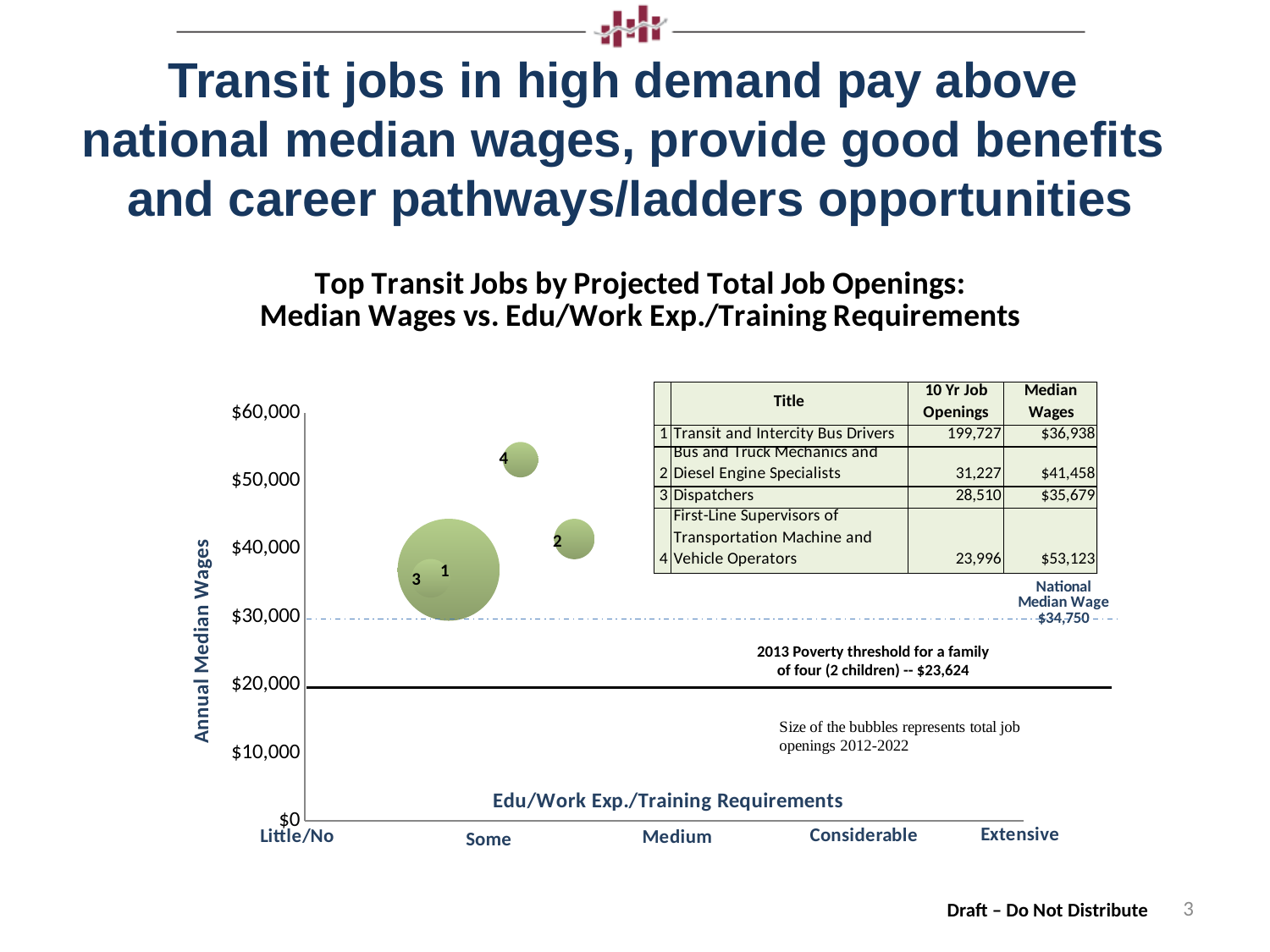
How many 10-year job openings are projected for Transit and Intercity Bus Drivers? 199,727 What is the median wage for Dispatchers? $35,679 What value does the National Median Wage reference line represent? $34,750 Which has the higher median wage: Bus and Truck Mechanics and Diesel Engine Specialists or Dispatchers? Bus and Truck Mechanics and Diesel Engine Specialists What is the 2013 poverty threshold for a family of four shown on the chart? $23,624 What is the difference in 10-year job openings between Bus and Truck Mechanics and Diesel Engine Specialists and Dispatchers? 2,717 Which job has the fewest 10-year job openings? First-Line Supervisors of Transportation Machine and Vehicle Operators Which job has the highest annual median wage? First-Line Supervisors of Transportation Machine and Vehicle Operators What is the difference in median wages between First-Line Supervisors of Transportation Machine and Vehicle Operators and Transit and Intercity Bus Drivers? $16,185 What kind of chart is shown on the slide? Bubble chart Is the median wage for bubble 4 (First-Line Supervisors) greater or less than $50,000? greater How many bubbles (jobs) are plotted on the chart? 4